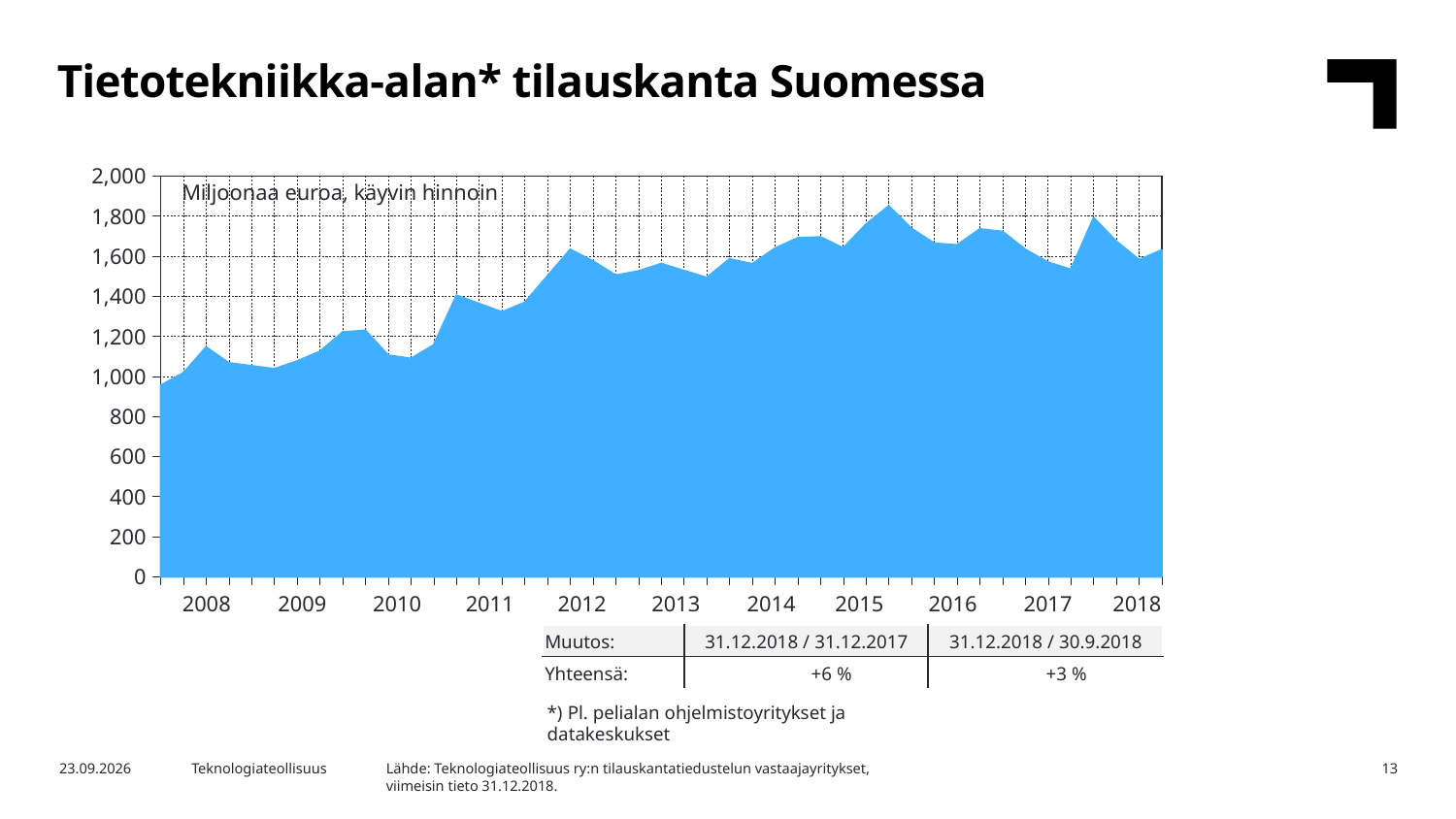
What unit is stated inside the chart area? Miljoonaa euroa, käyvin hinnoin Overall, do the values rise or fall from 2008 to 2018? rise Is the value at the start of 2009 greater or less than 1,400? less What is the title of the chart? Tietotekniikka-alan* tilauskanta Suomessa Is the value at the end of 2018 greater or less than 1,400? greater Which is larger, the value at the start of 2012 or the value at the start of 2010? 2012 In which year does the chart reach its highest value? 2015 What kind of chart is shown on the slide? area chart Is the value at the start of 2014 greater or less than 1,400? greater In which year is the chart's lowest value found? 2008 How many year labels are shown on the x axis? 11